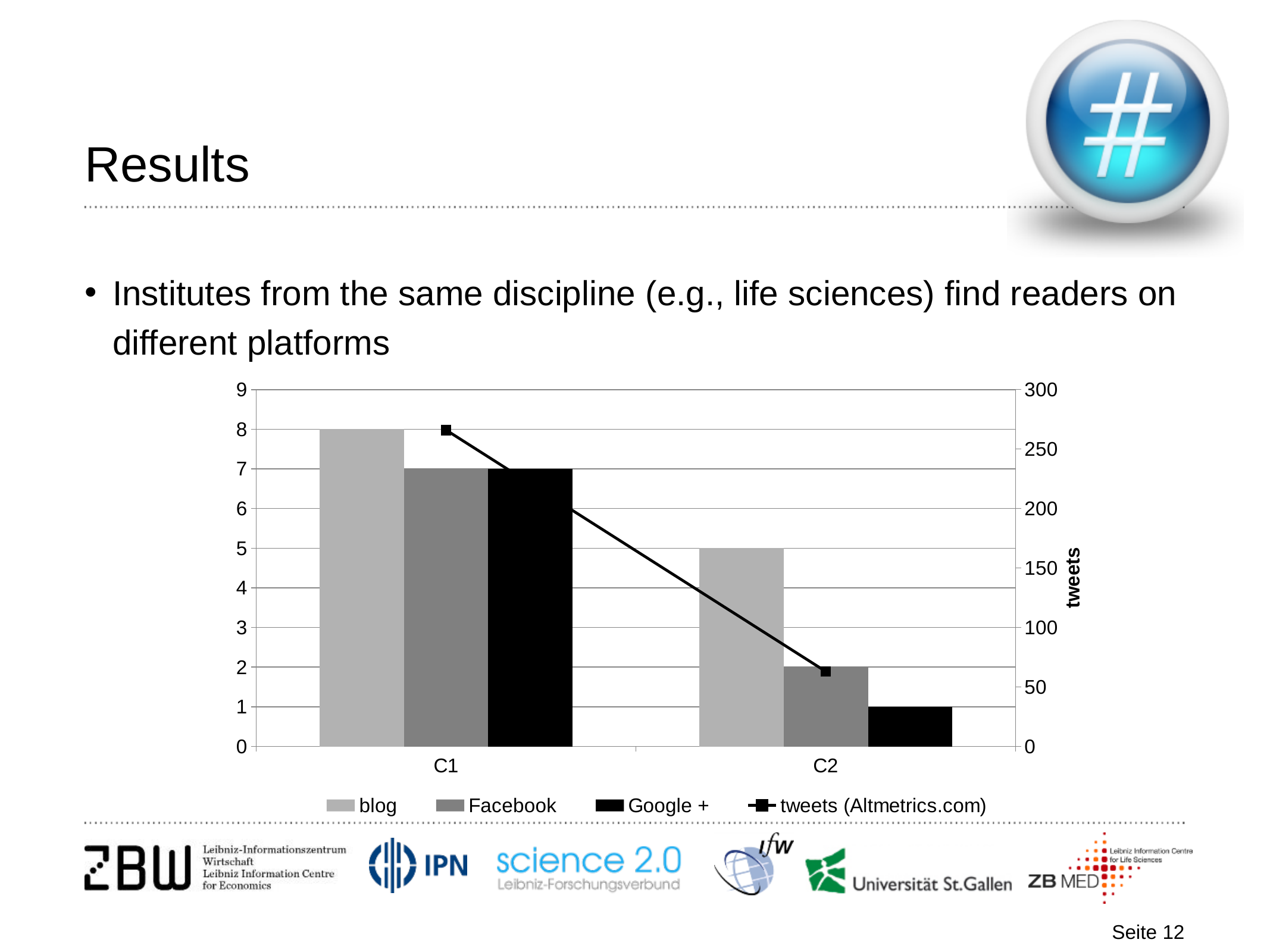
How many series does the legend list? 4 What is the Google + value for C2? 1 Which platform has the lowest bar for C2? Google + What is the blog value for C2? 5 What is the Facebook value for C2? 2 Which platform has the highest bar for C1? blog Is the tweets (Altmetrics.com) value for C1 greater or less than 250? greater What is the label of the right-hand vertical axis? tweets What is the difference between the blog values for C1 and C2? 3 Is the tweets (Altmetrics.com) value for C2 greater or less than 100? less What is the blog value for C1? 8 Which is larger, the Facebook value for C1 or the Facebook value for C2? C1